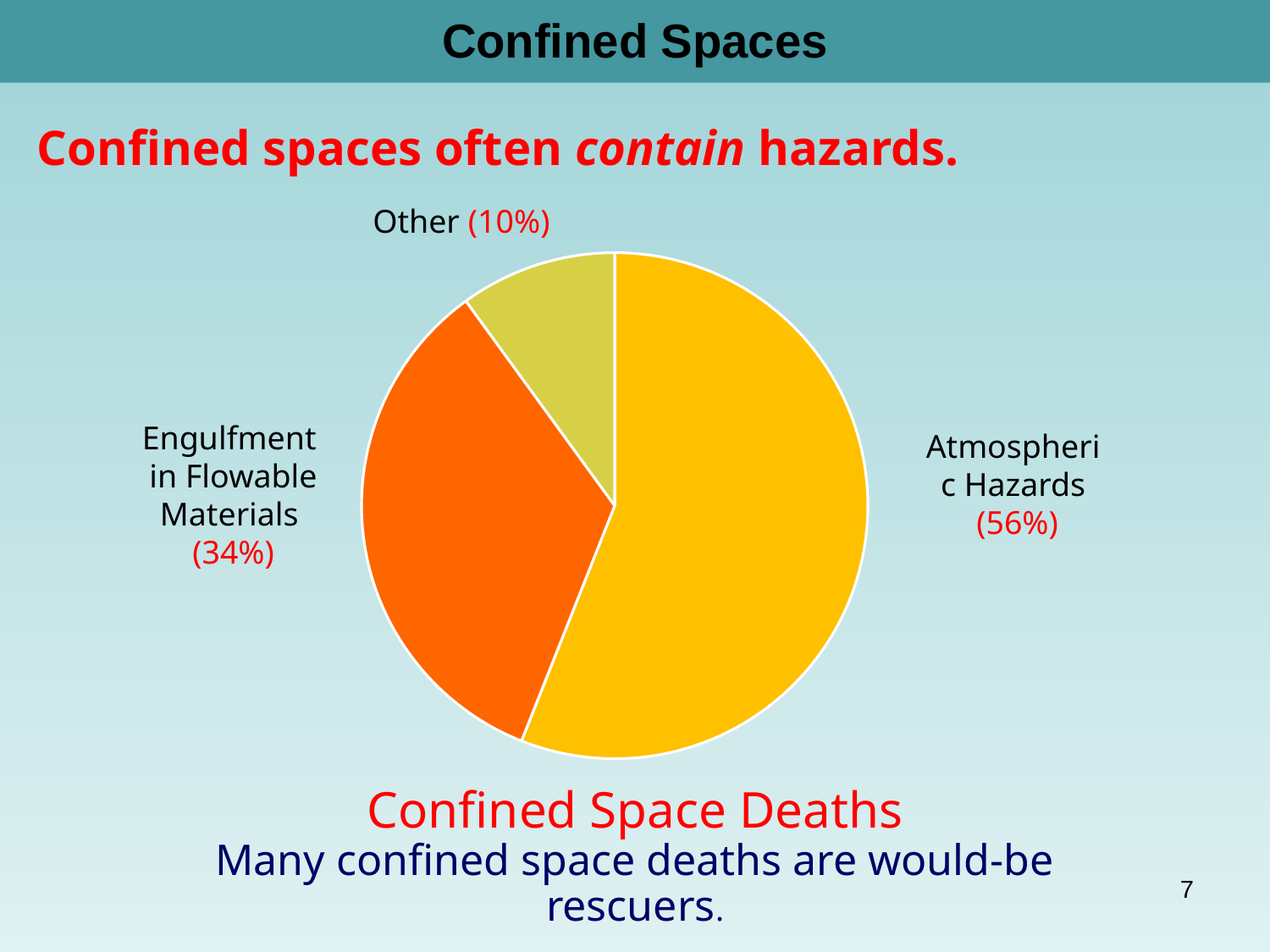
What kind of chart is shown on the slide? pie chart What share of confined space deaths is attributed to Atmospheric Hazards? 56% Which is larger: the share for Engulfment in Flowable Materials or the share for Other? Engulfment in Flowable Materials Which category accounts for the largest share of confined space deaths? Atmospheric Hazards What share of confined space deaths is attributed to Engulfment in Flowable Materials? 34% Which category accounts for the smallest share of confined space deaths? Other How many slices does the pie chart have? 3 How many percentage points larger is the Engulfment in Flowable Materials share than the Other share? 24 How many percentage points larger is the Atmospheric Hazards share than the Engulfment in Flowable Materials share? 22 What is the title shown below the pie chart? Confined Space Deaths What colour is the Atmospheric Hazards slice? yellow What share of confined space deaths falls under Other? 10%